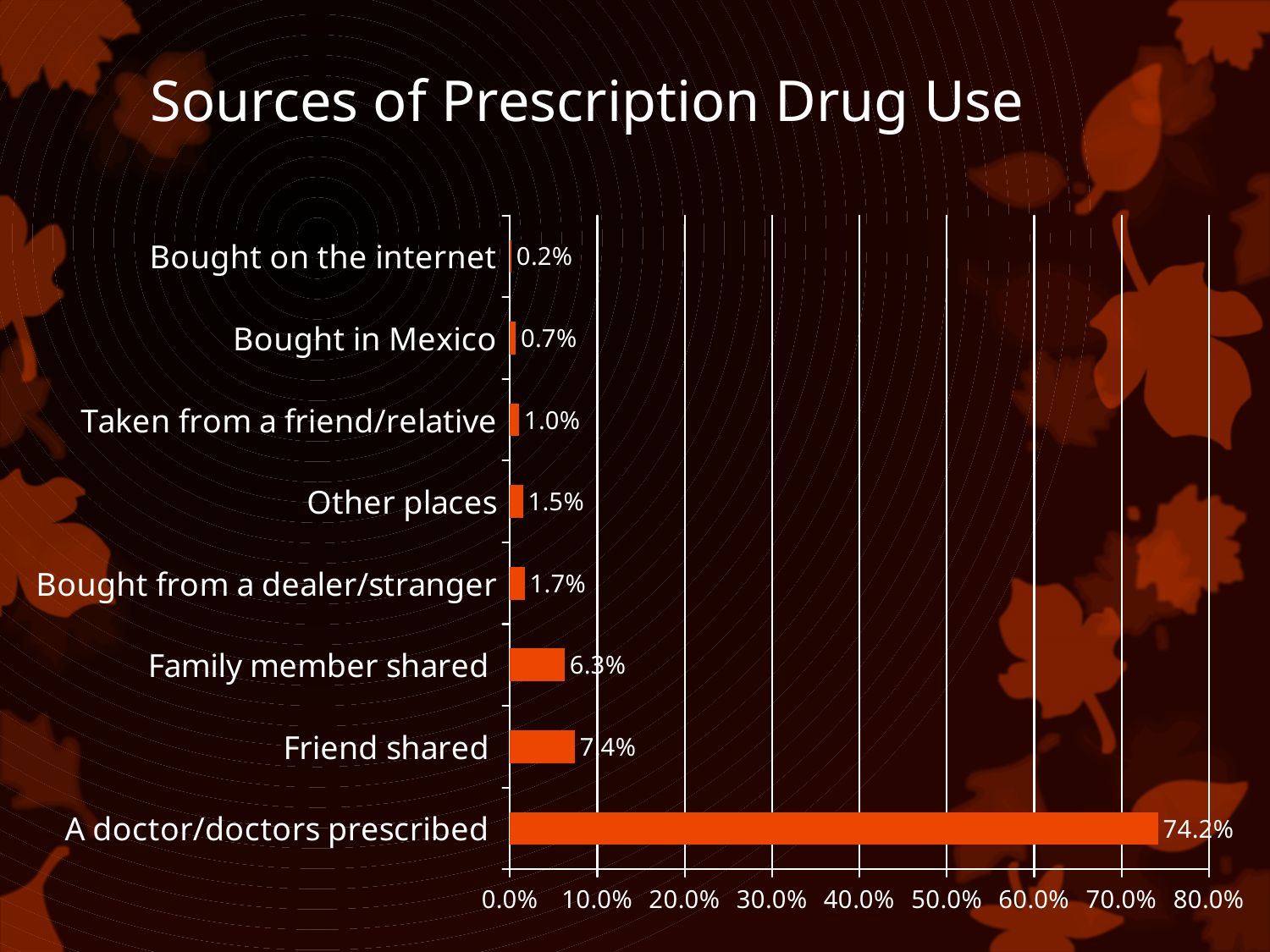
Which category has the lowest value? Bought on the internet Is the value for "A doctor/doctors prescribed" greater or less than 70.0%? greater What is the value for "Bought in Mexico"? 0.7% What is the difference between "Friend shared" and "Family member shared"? 1.1% Which is larger, "Other places" or "Taken from a friend/relative"? Other places What is the value for "Bought from a dealer/stranger"? 1.7% What type of chart is shown on the slide? Bar chart How many categories are shown in the chart? 8 What is the value for "Friend shared"? 7.4% What is the value for "A doctor/doctors prescribed"? 74.2% Which category has the highest value? A doctor/doctors prescribed What is the difference between "A doctor/doctors prescribed" and "Friend shared"? 66.8%